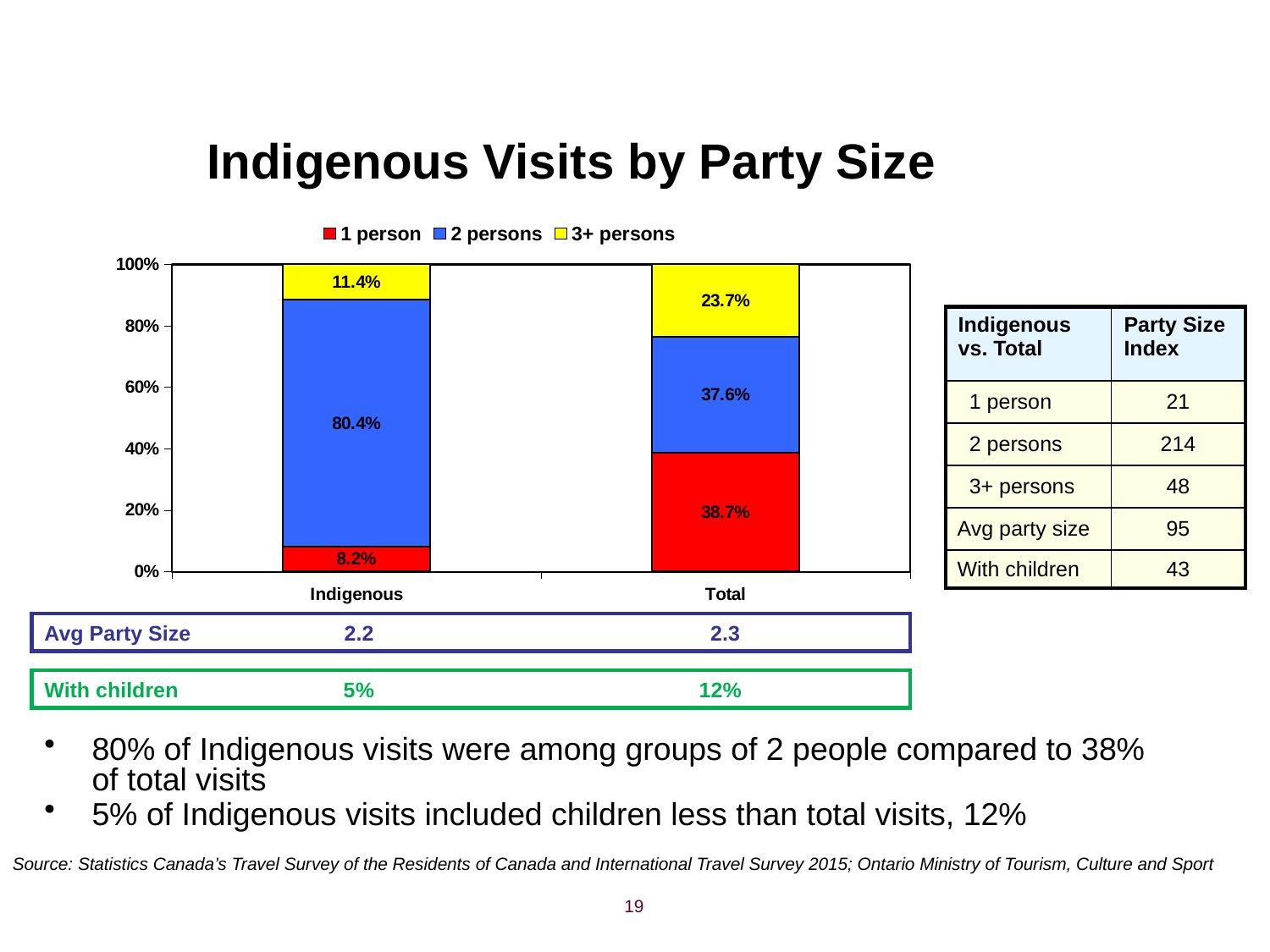
What is the difference between the 2 persons share for Indigenous visits and for Total visits? 42.8 percentage points How many categories are shown on the x axis of the chart? 2 Which colour represents the 2 persons series in the chart? Blue Which party size has the largest share of Indigenous visits? 2 persons What percentage of Total visits were by parties of 3+ persons? 23.7% What percentage of Indigenous visits were by 1 person? 8.2% Which is larger: the 3+ persons share for Indigenous visits or for Total visits? Total How many series does the legend list? 3 What percentage of Total visits were by 1 person? 38.7% What percentage of Indigenous visits were by parties of 2 persons? 80.4% What kind of chart is shown on the slide? Stacked bar chart Which party size has the smallest share of Total visits? 3+ persons